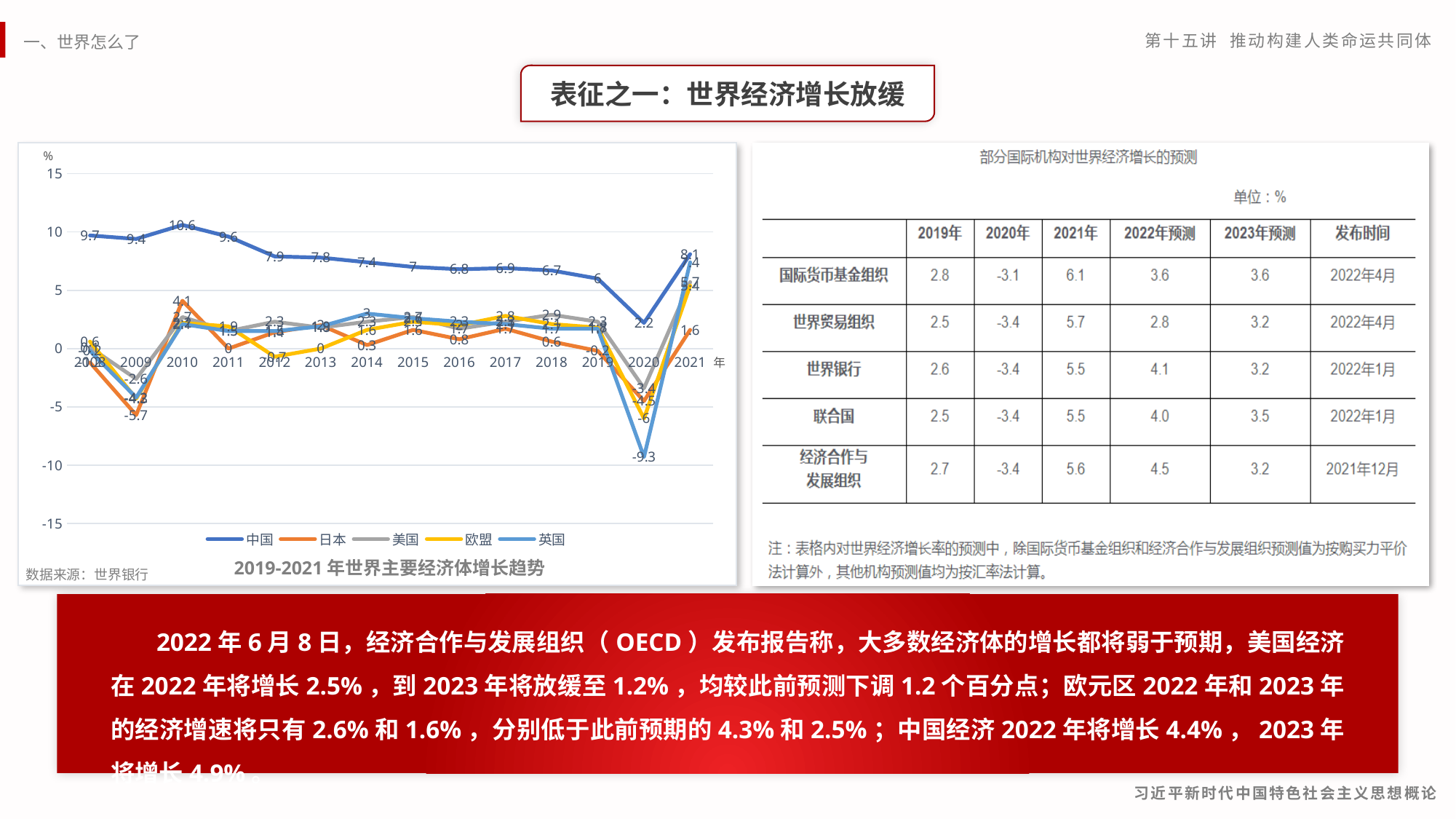
What type of chart is shown on the left side of the slide? line chart In the line chart, which series has the lowest value in 2020? 英国 In the line chart, is the value for 日本 in 2009 greater or less than -5? less In the line chart, what is the value for 中国 in 2010? 10.6 In the line chart, what is the value for 日本 in 2009? -5.7 In the line chart, what is the value for 中国 in 2020? 2.2 In the line chart, does the 中国 line rise or fall from 2010 to 2019? fall How many series does the legend of the line chart list? 5 In the line chart, what is the value for 英国 in 2020? -9.3 In the line chart, which is larger: the 中国 value in 2012 or in 2019? 2012 In the line chart, what is the difference between the 中国 values for 2021 and 2020? 5.9 In the line chart, in which year does 中国 reach its highest value? 2010